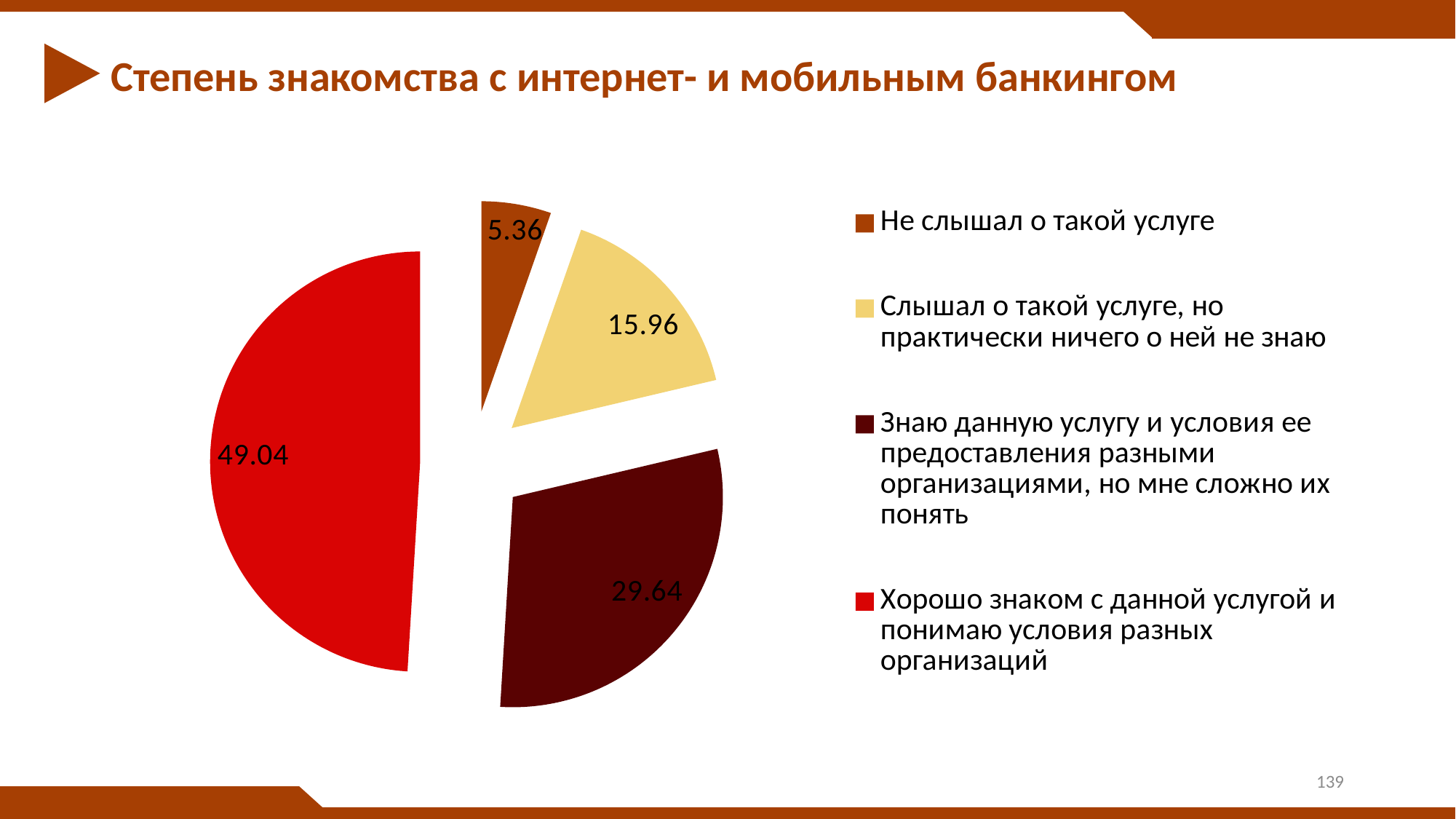
What is the title of the slide? Степень знакомства с интернет- и мобильным банкингом What is the value for the slice "Хорошо знаком с данной услугой и понимаю условия разных организаций"? 49.04 What colour is the slice for "Слышал о такой услуге, но практически ничего о ней не знаю"? light yellow What is the value for the slice "Знаю данную услугу и условия ее предоставления разными организациями, но мне сложно их понять"? 29.64 What is the difference between the values for "Хорошо знаком с данной услугой и понимаю условия разных организаций" and "Знаю данную услугу и условия ее предоставления разными организациями, но мне сложно их понять"? 19.40 What is the value for the slice "Слышал о такой услуге, но практически ничего о ней не знаю"? 15.96 How many slices does the pie chart have? 4 Which category has the smallest slice of the pie? Не слышал о такой услуге Which is larger: the slice "Слышал о такой услуге, но практически ничего о ней не знаю" or the slice "Не слышал о такой услуге"? Слышал о такой услуге, но практически ничего о ней не знаю What kind of chart is shown on the slide? pie chart What is the value for the slice "Не слышал о такой услуге"? 5.36 Which category has the largest slice of the pie? Хорошо знаком с данной услугой и понимаю условия разных организаций